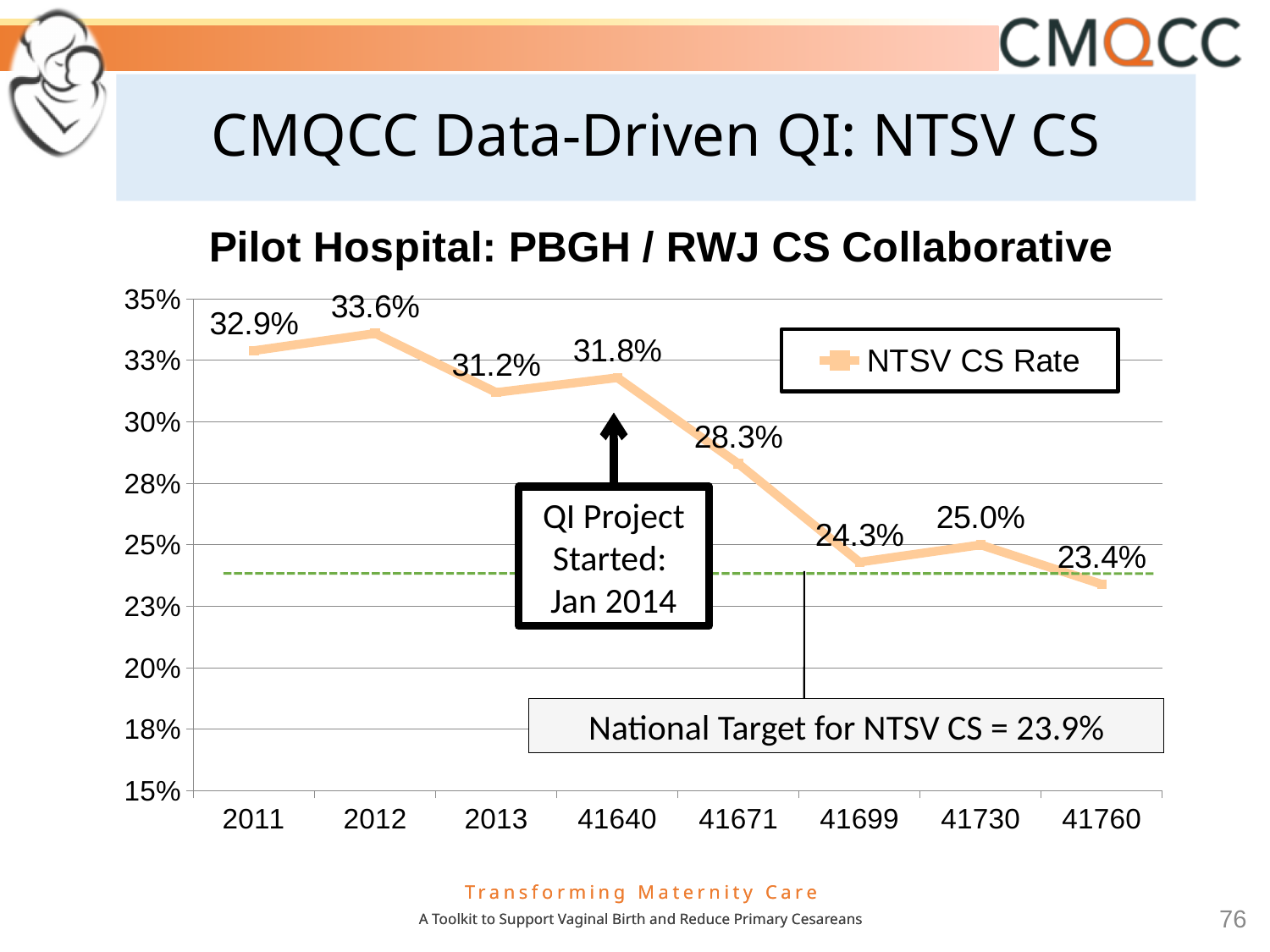
What kind of chart is shown on the slide? line chart Which is larger, the NTSV CS Rate for 2013 or for 41640? 41640 What is the difference between the NTSV CS Rate for 2012 and for 41760? 10.2% What is the National Target for NTSV CS shown on the chart? 23.9% What is the NTSV CS Rate for 2011? 32.9% What is the NTSV CS Rate for the category labelled 41699? 24.3% How many data points are plotted on the NTSV CS Rate line? 8 Which category has the highest NTSV CS Rate? 2012 How many series does the legend list? 1 What is the NTSV CS Rate for 2012? 33.6% Is the NTSV CS Rate for 41671 greater or less than 30%? less Which category has the lowest NTSV CS Rate? 41760